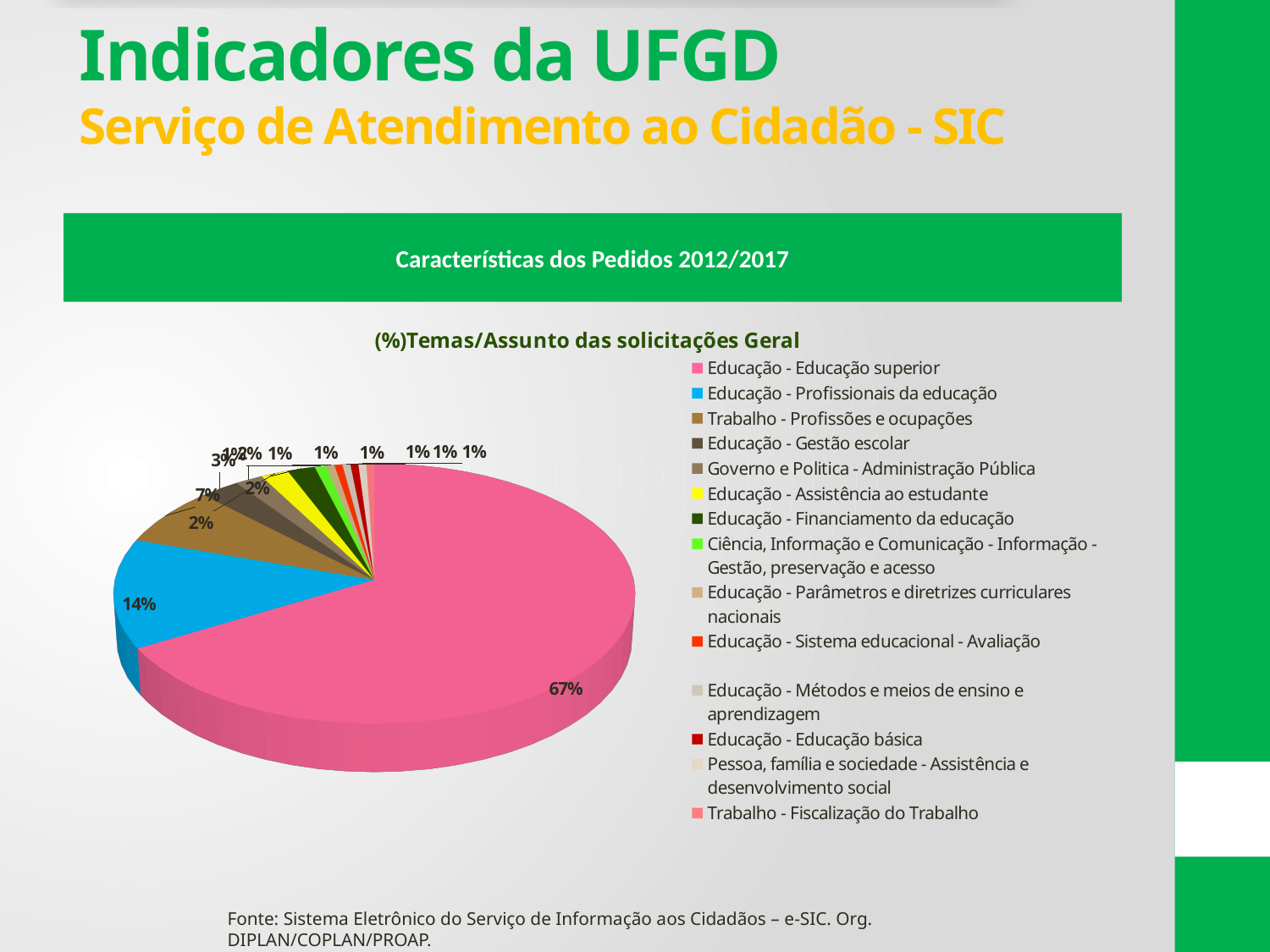
What type of chart is shown on the slide? pie chart What is the title of the chart? (%)Temas/Assunto das solicitações Geral Which category has the largest slice of the pie? Educação - Educação superior Which is larger: 'Educação - Educação superior' or 'Educação - Profissionais da educação'? Educação - Educação superior What share of the pie does 'Educação - Educação superior' represent? 67% What is the value for 'Educação - Profissionais da educação'? 14% How many categories does the legend list? 14 Which category is shown in pink in the pie chart? Educação - Educação superior Which colour represents 'Educação - Profissionais da educação' in the chart? blue What is the difference between the shares of 'Educação - Educação superior' and 'Educação - Profissionais da educação'? 53%